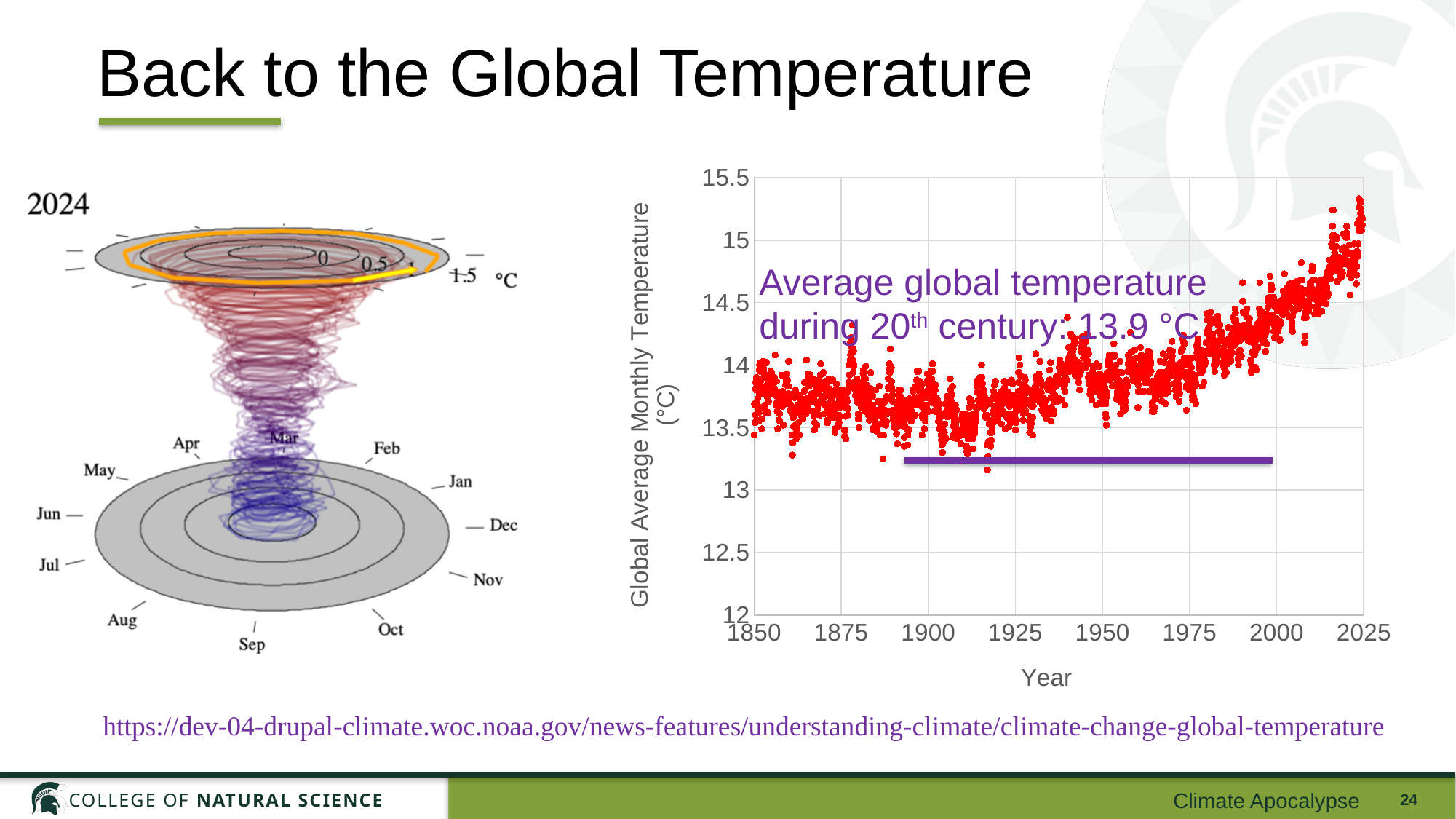
On the right-hand chart, are the temperatures plotted around 2020 higher or lower than those plotted around 1900? higher On the right-hand chart, are the temperature values plotted around 1900 greater or less than 14.5? less According to the annotation on the right-hand chart, what was the average global temperature during the 20th century? 13.9 °C On the right-hand chart, do the temperature values generally rise or fall as the year increases from 1850 to 2025? rise On the right-hand chart, what is the last year tick shown on the x axis? 2025 On the right-hand chart, are the temperature values plotted around 2024 greater or less than 15? greater On the right-hand chart, are the temperature values plotted around 1860 greater or less than 14? less On the right-hand chart, what kind of chart is used to show Global Average Monthly Temperature against Year? scatter chart On the right-hand chart, what is the label of the x axis? Year On the right-hand chart, what is the label of the y axis? Global Average Monthly Temperature (°C) On the right-hand chart, what is the lowest value shown on the y axis? 12